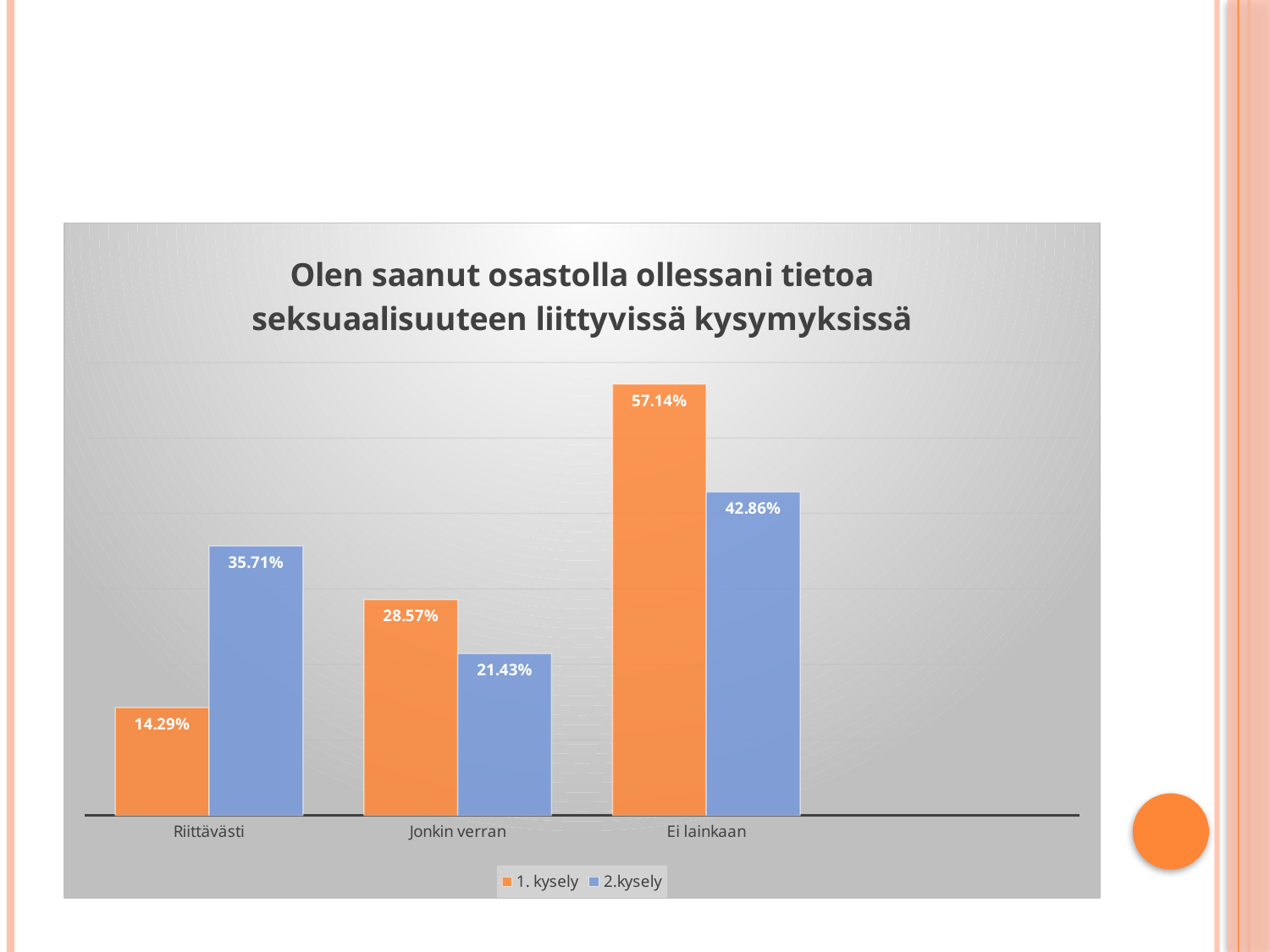
What is the difference between the "1. kysely" and "2.kysely" values in the "Ei lainkaan" category? 14.28% What is the value for "1. kysely" in the "Riittävästi" category? 14.29% In the "Riittävästi" category, which series has the larger value, "1. kysely" or "2.kysely"? 2.kysely Which category has the highest value for "1. kysely"? Ei lainkaan What colour are the bars for the "2.kysely" series? Blue How many series does the legend list? 2 What is the value for "2.kysely" in the "Ei lainkaan" category? 42.86% How many categories are shown on the x axis? 3 What kind of chart is shown on the slide? Bar chart Which category has the lowest value for "2.kysely"? Jonkin verran What is the value for "2.kysely" in the "Jonkin verran" category? 21.43% Do the "1. kysely" values rise or fall from "Riittävästi" to "Ei lainkaan"? Rise